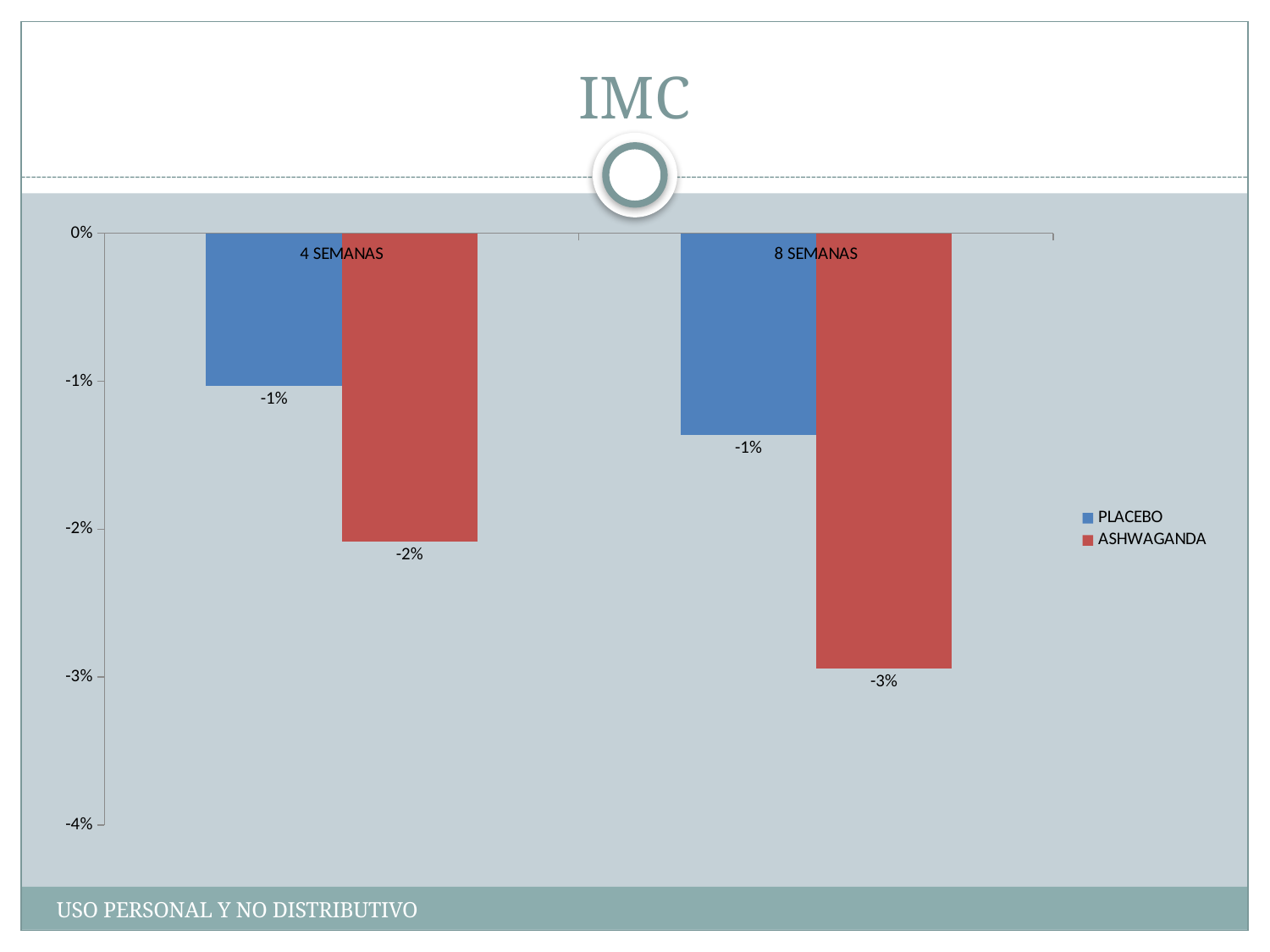
Is the value for ASHWAGANDA at 8 SEMANAS greater or less than -2%? less How many categories are shown on the x axis? 2 Which bar shows the largest decrease (the lowest value) in the chart? ASHWAGANDA at 8 SEMANAS What is the value for ASHWAGANDA at 8 SEMANAS? -3% What is the value for PLACEBO at 8 SEMANAS? -1% What kind of chart is shown on the slide? Bar chart Which bar shows the smallest decrease (the value closest to 0%) in the chart? PLACEBO at 4 SEMANAS How many series does the legend list? 2 What is the value for ASHWAGANDA at 4 SEMANAS? -2% At 8 SEMANAS, which series has the larger decrease, PLACEBO or ASHWAGANDA? ASHWAGANDA What is the value for PLACEBO at 4 SEMANAS? -1%